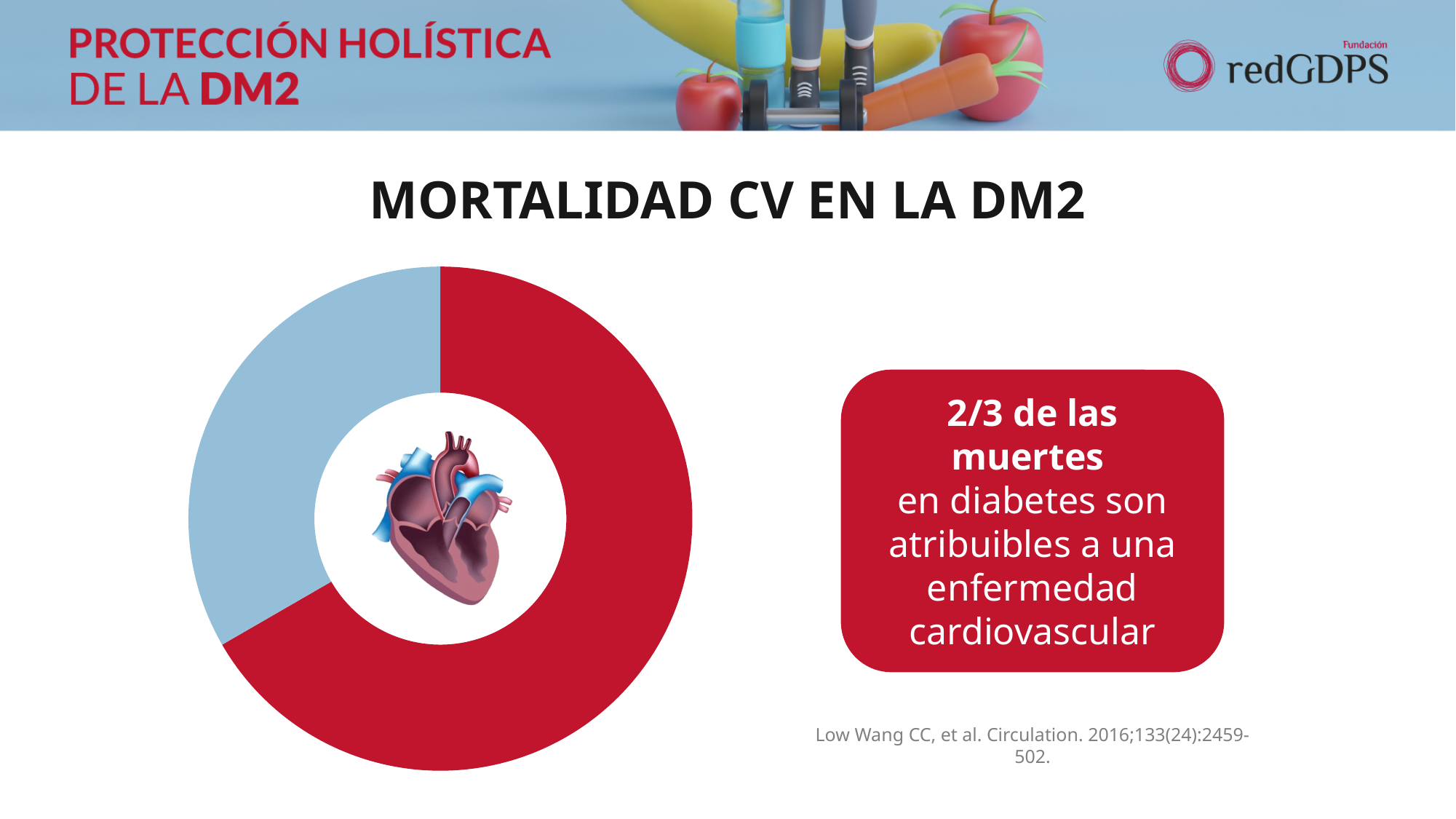
Which colour represents the smallest slice of the pie chart? Light blue What kind of chart is shown on the slide? Pie (donut) chart According to the slide, what share of deaths in diabetes are attributable to cardiovascular disease? 2/3 Is the red slice of the pie chart greater or less than half of the pie? greater Which slice of the pie chart is larger, the red one or the light blue one? The red one Which colour represents the largest slice of the pie chart? Red How many slices does the pie chart have? 2 What is the title of the slide containing the pie chart? MORTALIDAD CV EN LA DM2 What image is placed in the centre of the donut chart? A heart